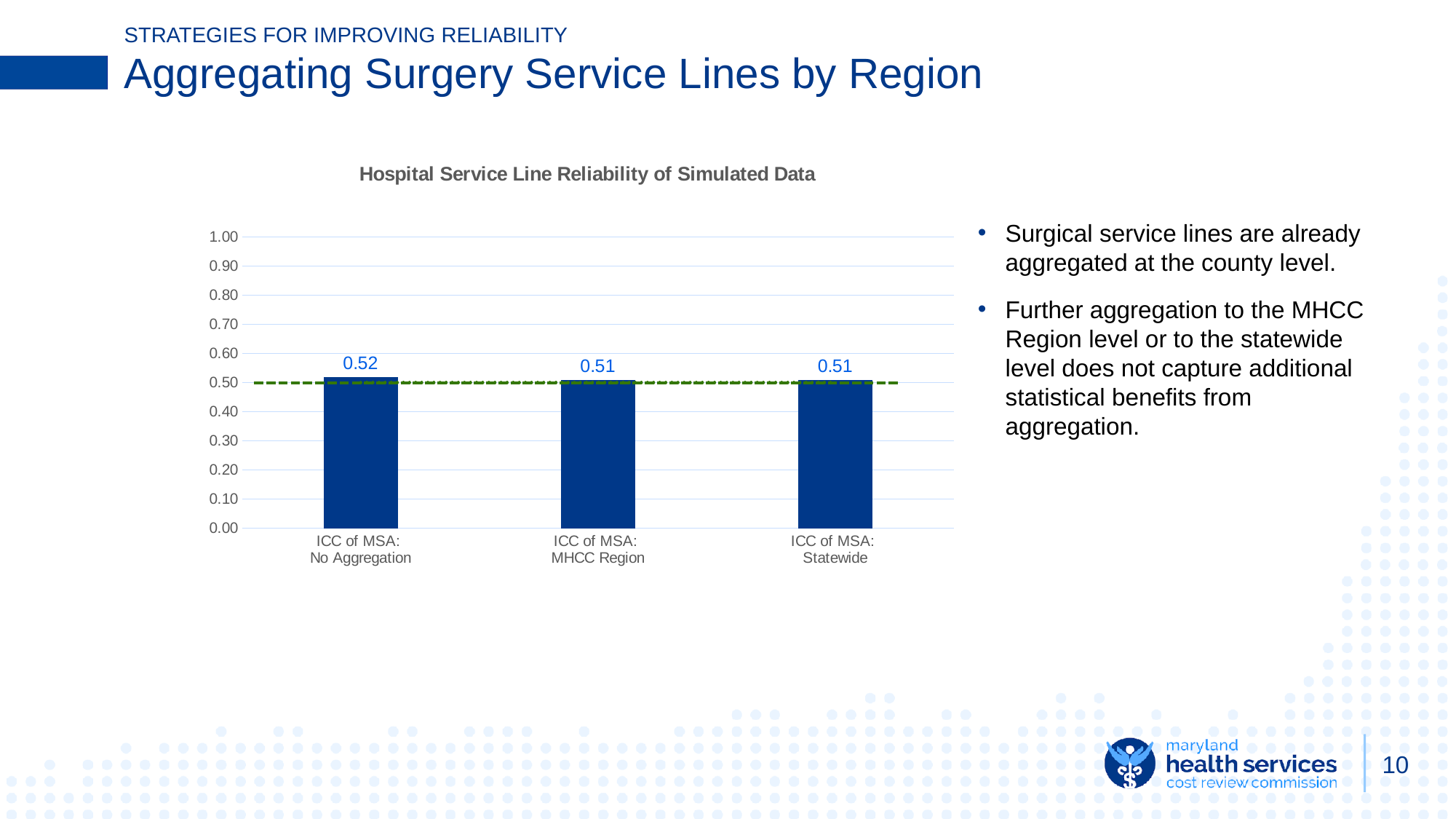
What is the value for ICC of MSA: MHCC Region? 0.51 Which is larger, the value for ICC of MSA: No Aggregation or the value for ICC of MSA: Statewide? ICC of MSA: No Aggregation What is the title of the chart? Hospital Service Line Reliability of Simulated Data What is the value for ICC of MSA: Statewide? 0.51 At what value on the y axis is the green dashed horizontal line drawn? 0.50 What is the value for ICC of MSA: No Aggregation? 0.52 What is the difference between the values for ICC of MSA: No Aggregation and ICC of MSA: MHCC Region? 0.01 Which category has the highest value? ICC of MSA: No Aggregation How many categories are shown on the x axis? 3 Is the value for ICC of MSA: MHCC Region greater or less than 0.60? less Is the value for ICC of MSA: Statewide greater or less than 0.40? greater What kind of chart is shown on the slide? Bar chart